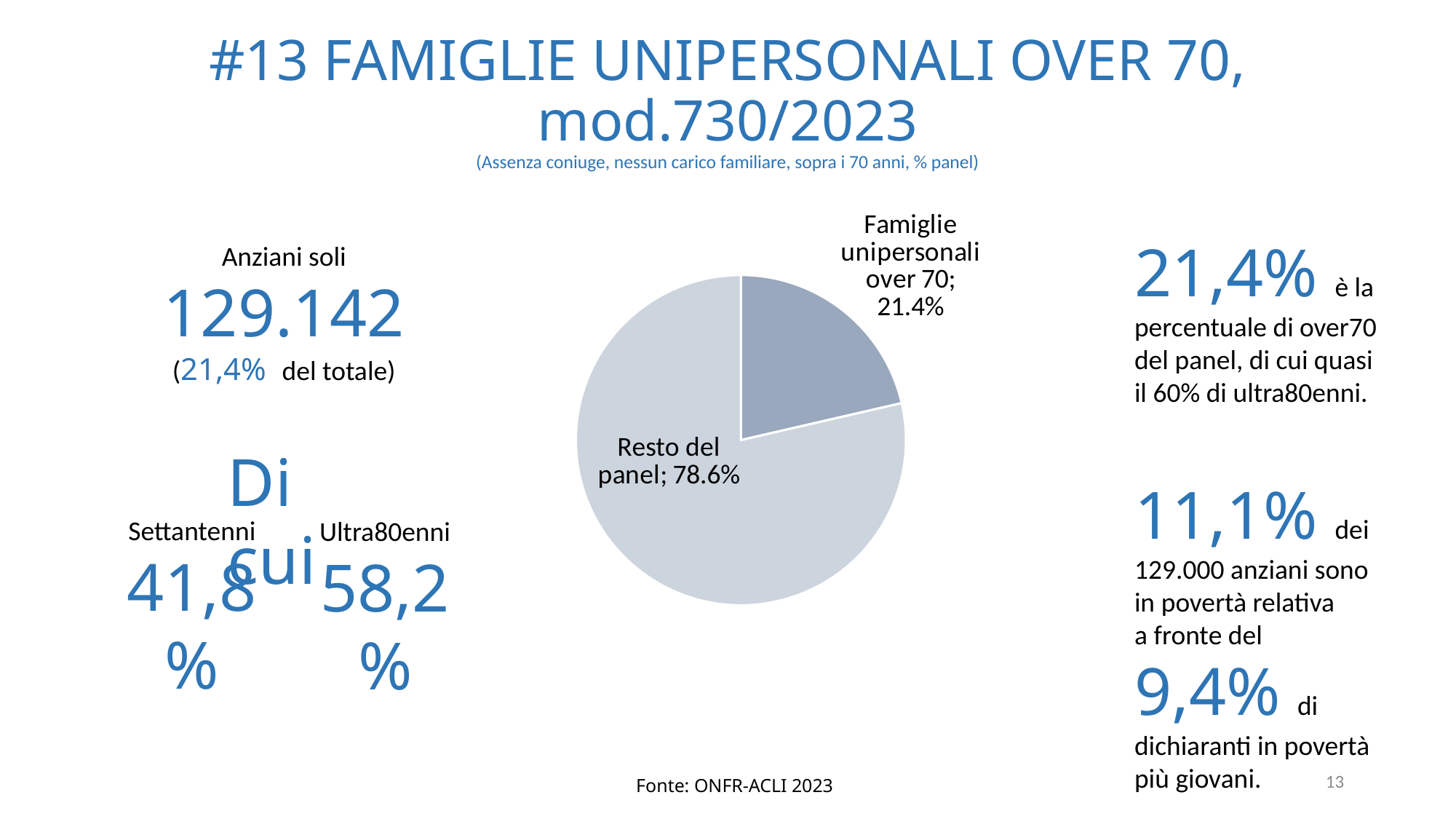
How many slices does the pie chart have? 2 Which slice of the pie chart is the largest? Resto del panel Is the share for "Famiglie unipersonali over 70" greater or less than 50%? less Which slice of the pie chart is the smallest? Famiglie unipersonali over 70 What share of the pie is labelled "Famiglie unipersonali over 70"? 21.4% Which is larger in the pie chart: "Resto del panel" or "Famiglie unipersonali over 70"? Resto del panel What is the difference in percentage points between the "Resto del panel" slice and the "Famiglie unipersonali over 70" slice? 57.2 What do the two slices of the pie chart add up to? 100% What kind of chart is shown on the slide? pie chart What source is cited below the pie chart? Fonte: ONFR-ACLI 2023 What share of the pie is labelled "Resto del panel"? 78.6% Which slice of the pie chart is drawn in the darker blue-grey colour? Famiglie unipersonali over 70